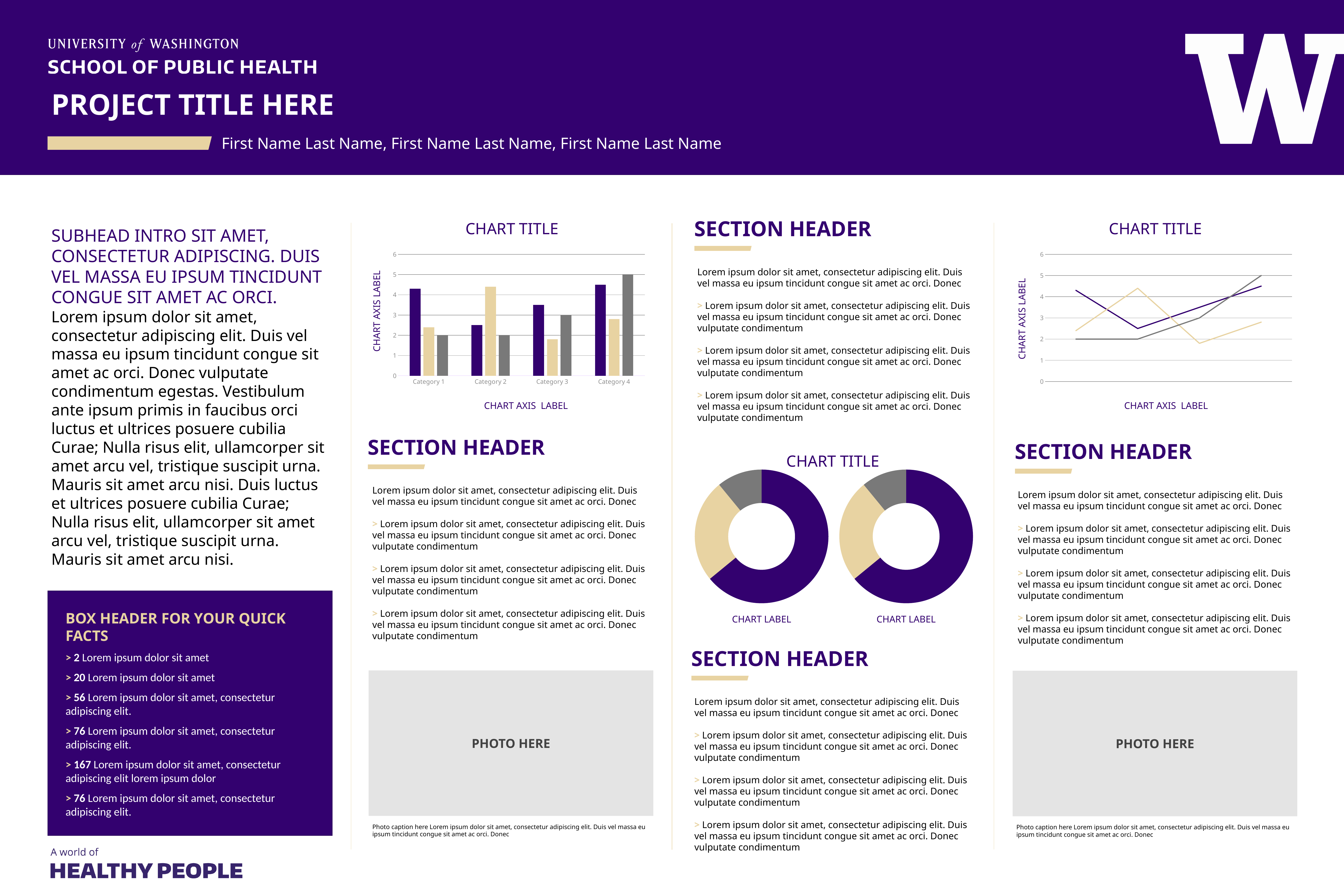
What kind of charts are the two charts labelled 'CHART LABEL' in the middle-right column? donut charts In the bar chart with Category 1 to Category 4, which category has the tallest gray bar? Category 4 What kind of chart is the chart in the top of the middle-left column, titled 'CHART TITLE' with Category 1 to Category 4? bar chart In the bar chart with Category 1 to Category 4, is the value of the tan bar for Category 3 greater or less than 2? less In the bar chart with Category 1 to Category 4, is the value of the purple bar for Category 1 greater or less than 4? greater In the line chart at the top of the right-hand column, how many lines are plotted? 3 What kind of chart is the chart at the top of the right-hand column, titled 'CHART TITLE'? line chart In the bar chart with Category 1 to Category 4, what is the highest value shown on the vertical axis? 6 In the bar chart with Category 1 to Category 4, how many categories are shown on the x axis? 4 In the bar chart with Category 1 to Category 4, which category has the tallest tan bar? Category 2 In the bar chart with Category 1 to Category 4, which is larger for Category 2: the purple bar or the tan bar? the tan bar In the bar chart with Category 1 to Category 4, is the value of the gray bar for Category 4 greater or less than 4? greater